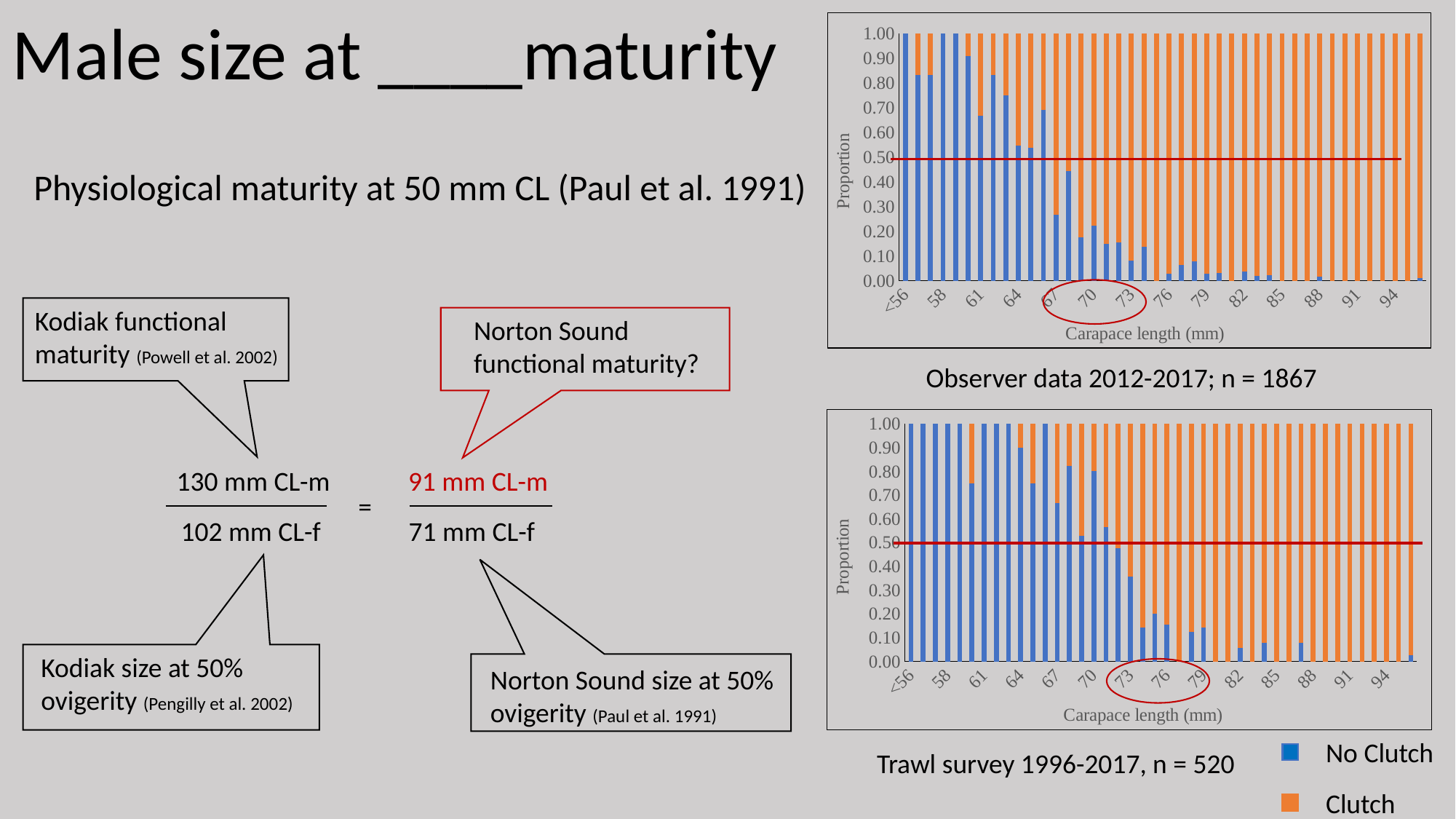
In the top chart (Observer data 2012-2017), does the Clutch proportion rise or fall as carapace length increases? rise What are the two series named in the legend? No Clutch and Clutch In the bottom chart (Trawl survey 1996-2017), is the No Clutch proportion at carapace length <56 greater or less than 0.50? greater How many series does the legend list for the charts? 2 In the bottom chart (Trawl survey 1996-2017), is the No Clutch proportion at carapace length 91 greater or less than 0.50? less In the top chart (Observer data 2012-2017), is the No Clutch proportion at carapace length 58 greater or less than 0.50? greater At what proportion value is the horizontal red line drawn in both charts? 0.50 What kind of chart is the top chart (Observer data 2012-2017)? Stacked bar chart In the bottom chart (Trawl survey 1996-2017), does the No Clutch proportion rise or fall as carapace length increases? fall